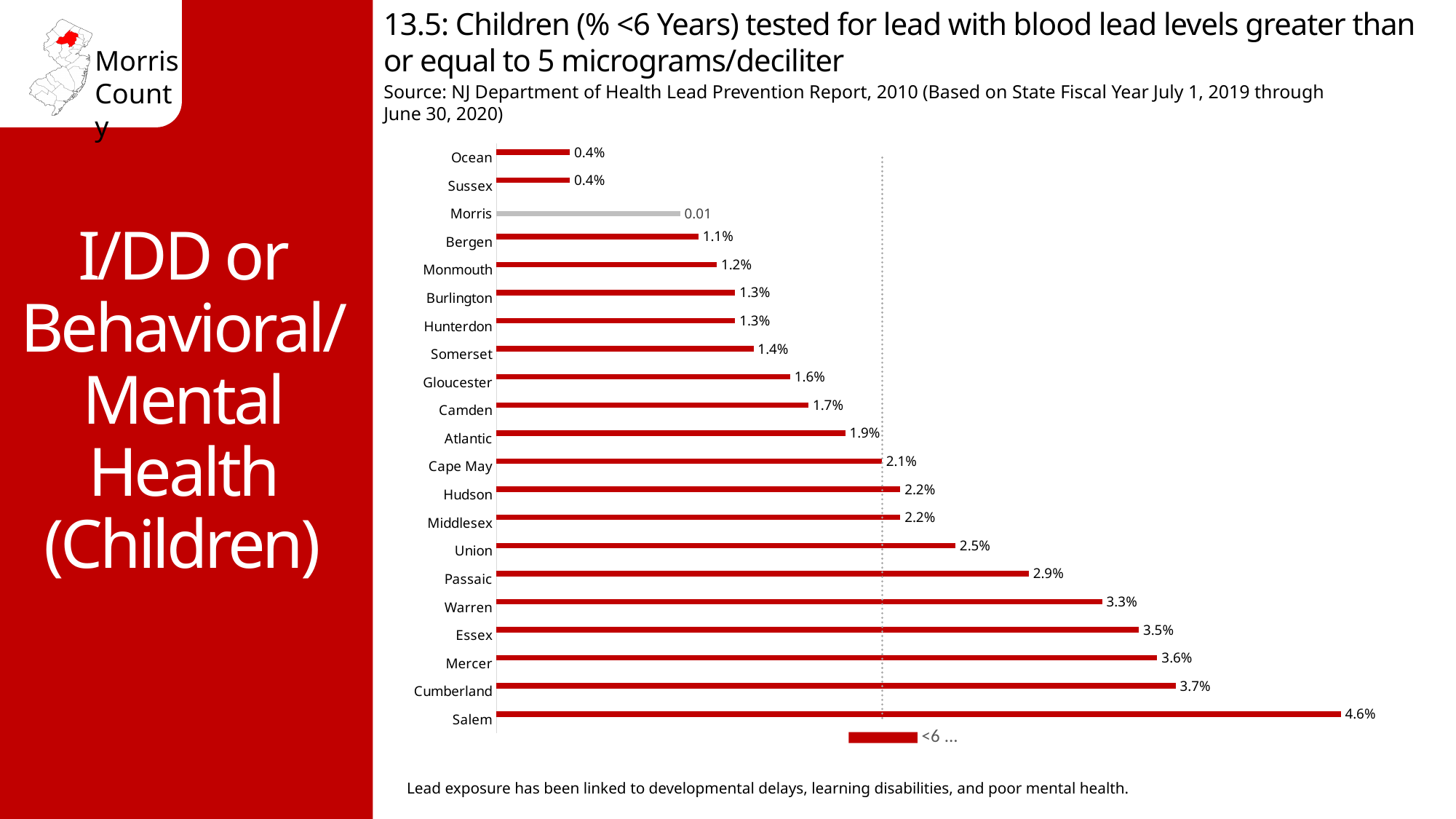
Which county's bar is shown in grey rather than red? Morris How many counties are shown in the chart? 21 What kind of chart is this? bar chart What value is printed next to the Morris bar? 0.01 What is the value for Cumberland? 3.7% What is the value for Bergen? 1.1% What is the difference between the values for Salem and Cumberland? 0.9% Which county has the highest value? Salem What is the difference between the values for Passaic and Union? 0.4% What is the value for Hudson? 2.2% Which has a larger value, Essex or Warren? Essex What is the value for Salem? 4.6%